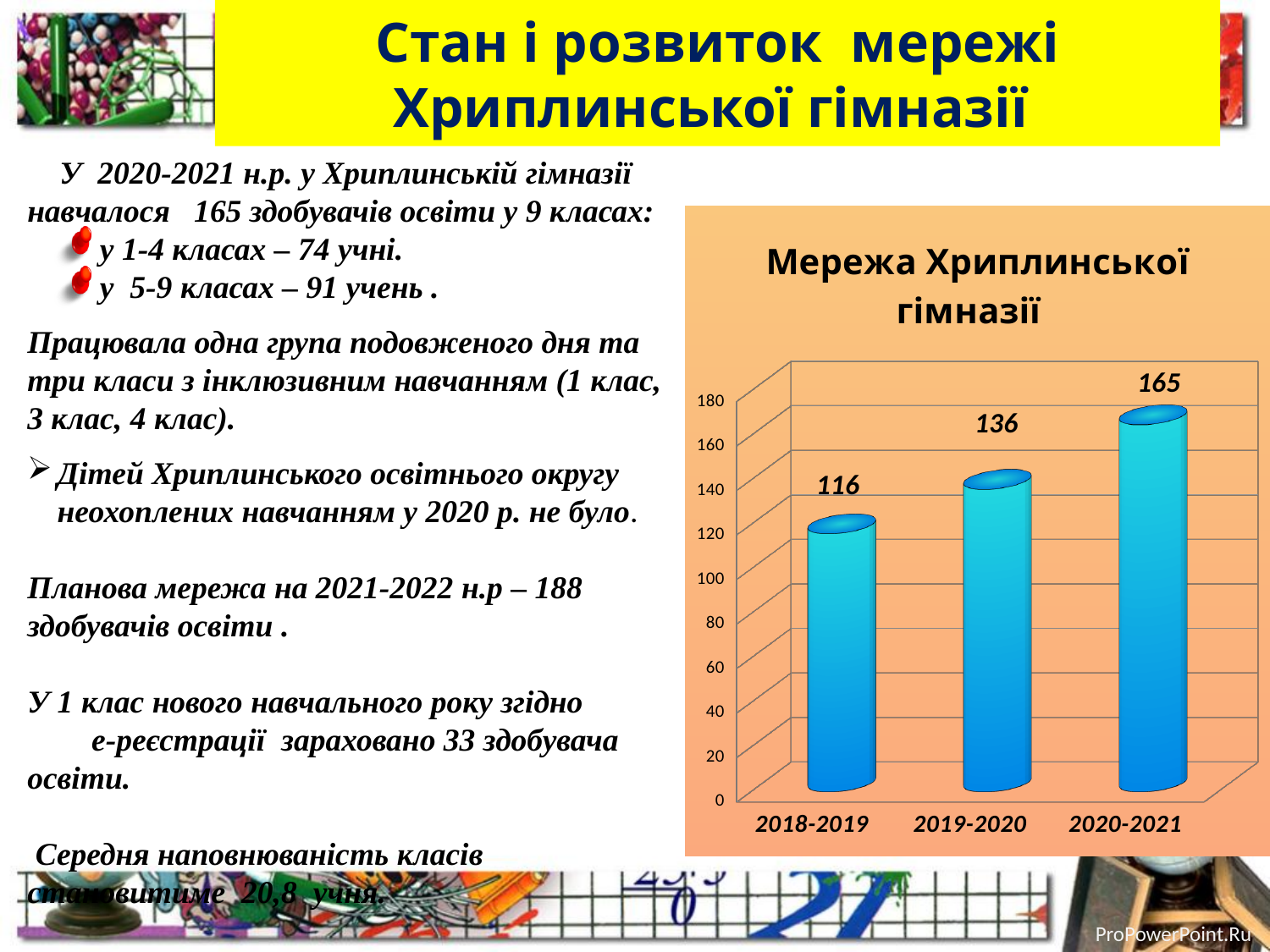
What is the value for 2018-2019 in the chart? 116 What is the value for 2020-2021 in the chart? 165 Which is larger, the value for 2019-2020 or the value for 2020-2021? 2020-2021 What is the difference between the values for 2019-2020 and 2018-2019? 20 Which school year has the highest value in the chart? 2020-2021 What is the difference between the values for 2020-2021 and 2018-2019? 49 What is the value for 2019-2020 in the chart? 136 How many school years are shown on the x axis of the chart? 3 Is the value for 2019-2020 greater or less than 120? greater Which school year has the lowest value in the chart? 2018-2019 Do the values rise or fall from 2018-2019 to 2020-2021? rise What kind of chart is shown on the slide? bar chart